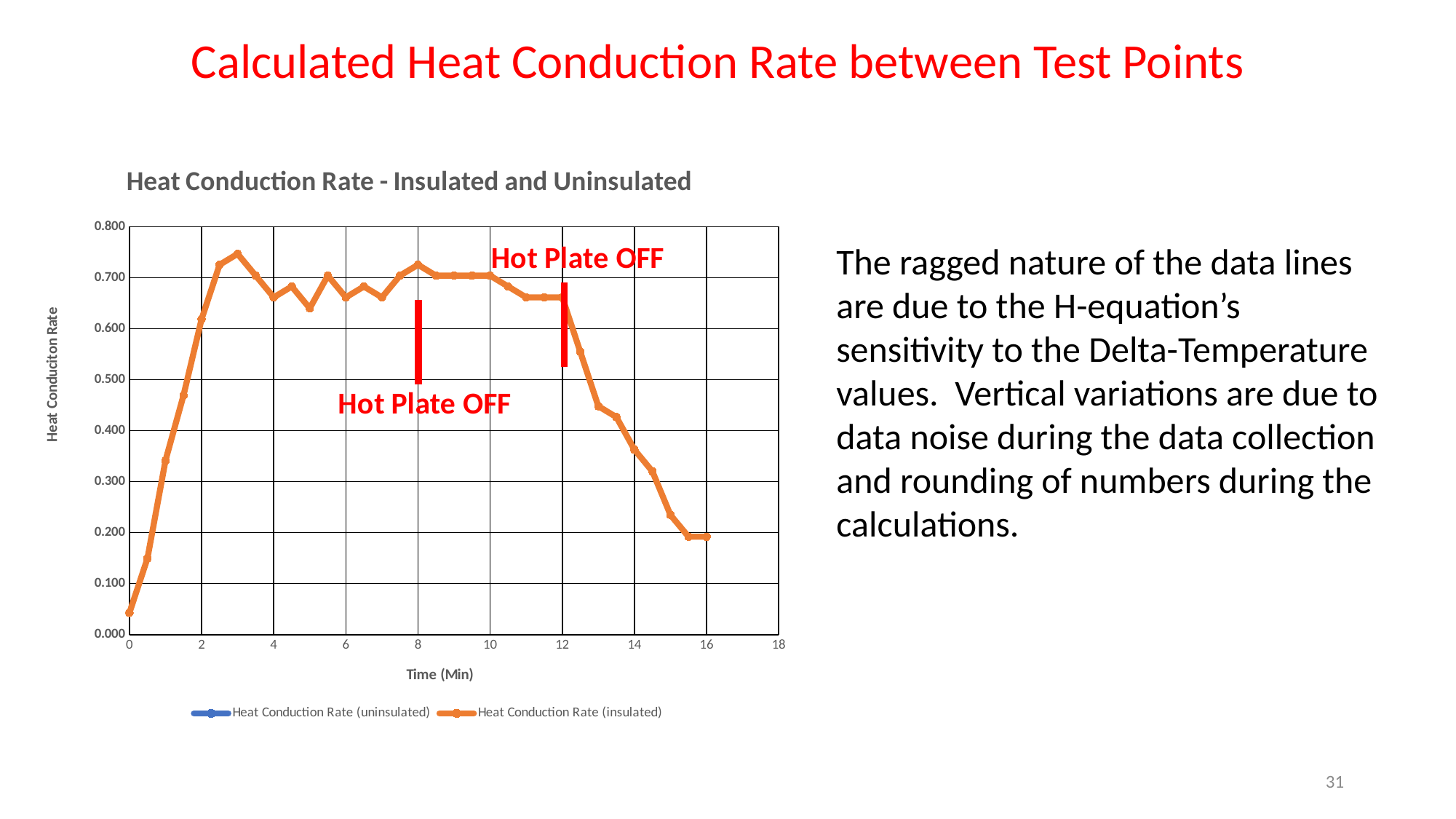
Is the heat conduction rate (insulated) at 2 minutes greater or less than 0.500? greater Which is larger, the heat conduction rate (insulated) at 3 minutes or at 16 minutes? 3 minutes Does the heat conduction rate (insulated) rise or fall between 12 and 16 minutes? fall How many series does the chart legend list? 2 Is the heat conduction rate (insulated) at 3 minutes greater or less than 0.700? greater Is the heat conduction rate (insulated) at 1 minute greater or less than 0.400? less What is the label of the x axis of the chart? Time (Min) What is the title of the chart? Heat Conduction Rate - Insulated and Uninsulated Does the heat conduction rate (insulated) rise or fall between 0 and 3 minutes? rise What kind of chart is shown on the slide? line chart